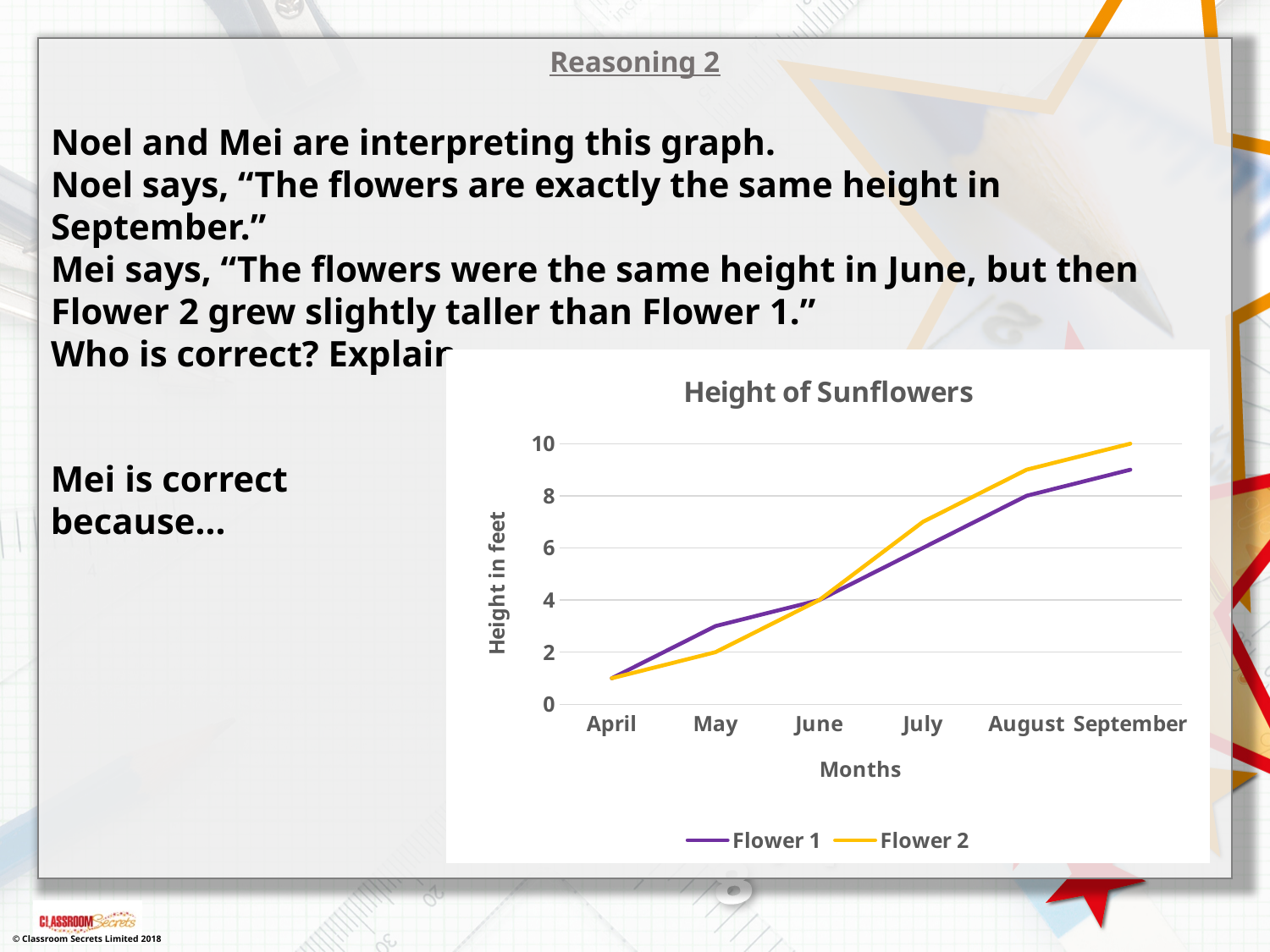
Do the heights of the flowers rise or fall from April to September? rise What is the height of Flower 2 in September? 10 What is the height of Flower 1 in August? 8 What is the title of the chart? Height of Sunflowers What kind of chart is shown on the slide? line chart What is the height of Flower 1 in June? 4 In which month is Flower 2 at its greatest height? September How many series does the legend list? 2 Is the value for Flower 2 in August greater or less than 8? greater Is the value for Flower 1 in September greater or less than 10? less How many months are shown on the x axis? 6 In September, which flower is taller, Flower 1 or Flower 2? Flower 2